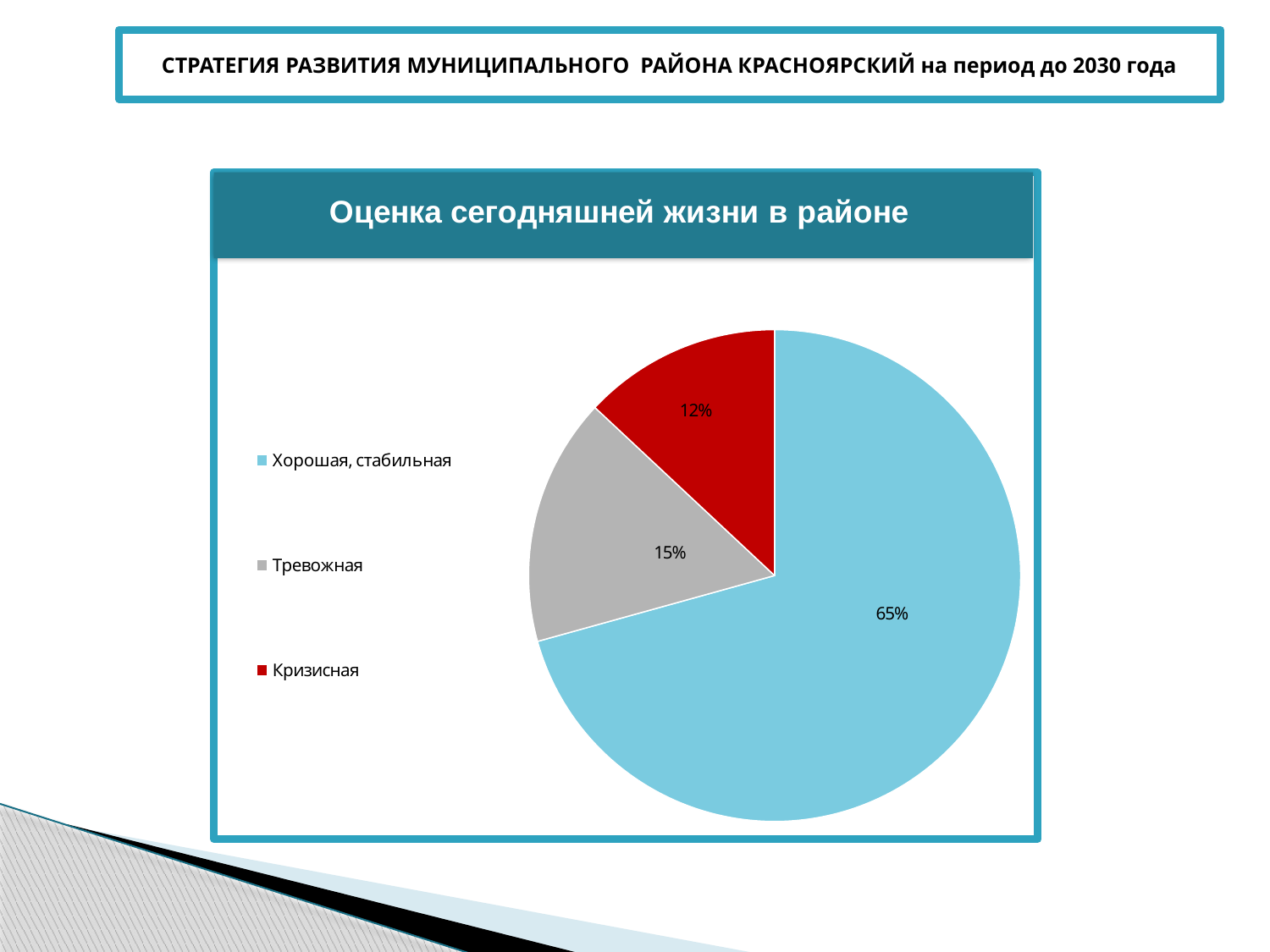
What kind of chart is shown on the slide? pie chart What share of the pie is labelled "Хорошая, стабильная"? 65% Which category has the largest slice of the pie? Хорошая, стабильная What colour is the slice for "Кризисная"? red What is the difference between the shares for "Хорошая, стабильная" and "Тревожная"? 50% Which is larger, the share for "Тревожная" or the share for "Кризисная"? Тревожная What share of the pie is labelled "Тревожная"? 15% What share of the pie is labelled "Кризисная"? 12% What is the title of the chart? Оценка сегодняшней жизни в районе Which category has the smallest slice of the pie? Кризисная What is the difference between the shares for "Тревожная" and "Кризисная"? 3% How many categories does the pie chart show? 3